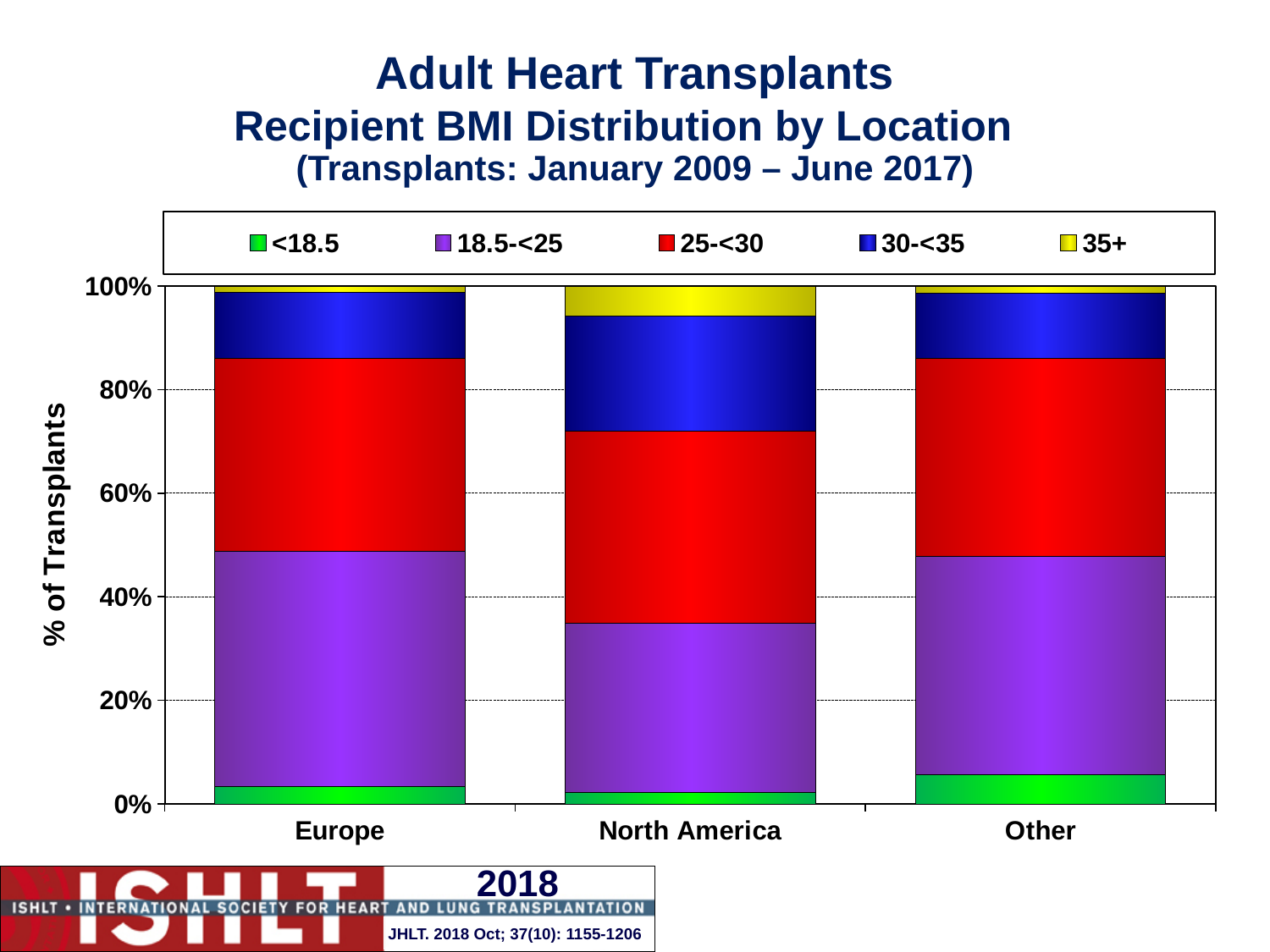
Which location has the largest <18.5 BMI segment? Other How many BMI categories does the legend list? 5 Which is larger for Europe: the 18.5-<25 segment or the 30-<35 segment? 18.5-<25 What is the label of the y axis? % of Transplants Is the 18.5-<25 segment for North America greater or less than 40%? less Is the 18.5-<25 segment for Europe greater or less than 40%? greater What kind of chart is shown on the slide? stacked bar chart Which location has the smallest 18.5-<25 BMI segment? North America Which location has the largest 30-<35 BMI segment? North America How many locations are shown on the x axis? 3 Is the 30-<35 segment for North America greater or less than 40%? less Which location has the largest 35+ BMI segment? North America